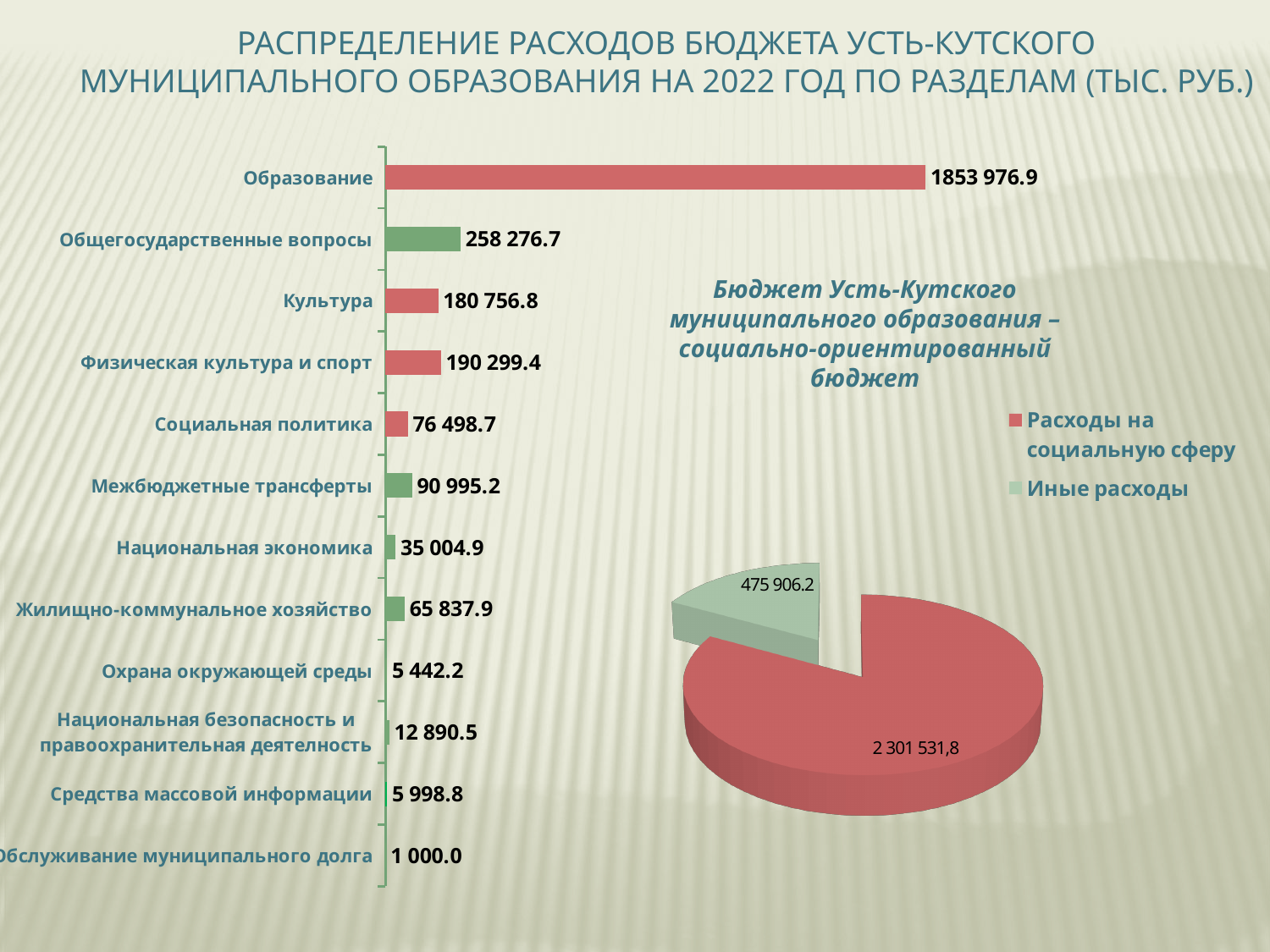
On the bar chart on the left, what is the difference between Физическая культура и спорт and Культура? 9 542.6 On the bar chart on the left, what is the value for Образование? 1853 976.9 How many categories does the bar chart on the left show? 12 On the bar chart on the left, what is the value for Межбюджетные трансферты? 90 995.2 On the bar chart on the left, which is larger: Социальная политика or Межбюджетные трансферты? Межбюджетные трансферты What kind of chart is the chart on the left of the slide? Bar chart On the bar chart on the left, what is the value for Обслуживание муниципального долга? 1 000.0 On the bar chart on the left, which category has the lowest value? Обслуживание муниципального долга On the pie chart on the right, what is the value for Расходы на социальную сферу? 2 301 531,8 How many series does the legend of the pie chart on the right list? 2 On the bar chart on the left, which category has the highest value? Образование On the pie chart on the right, what is the value for Иные расходы? 475 906.2